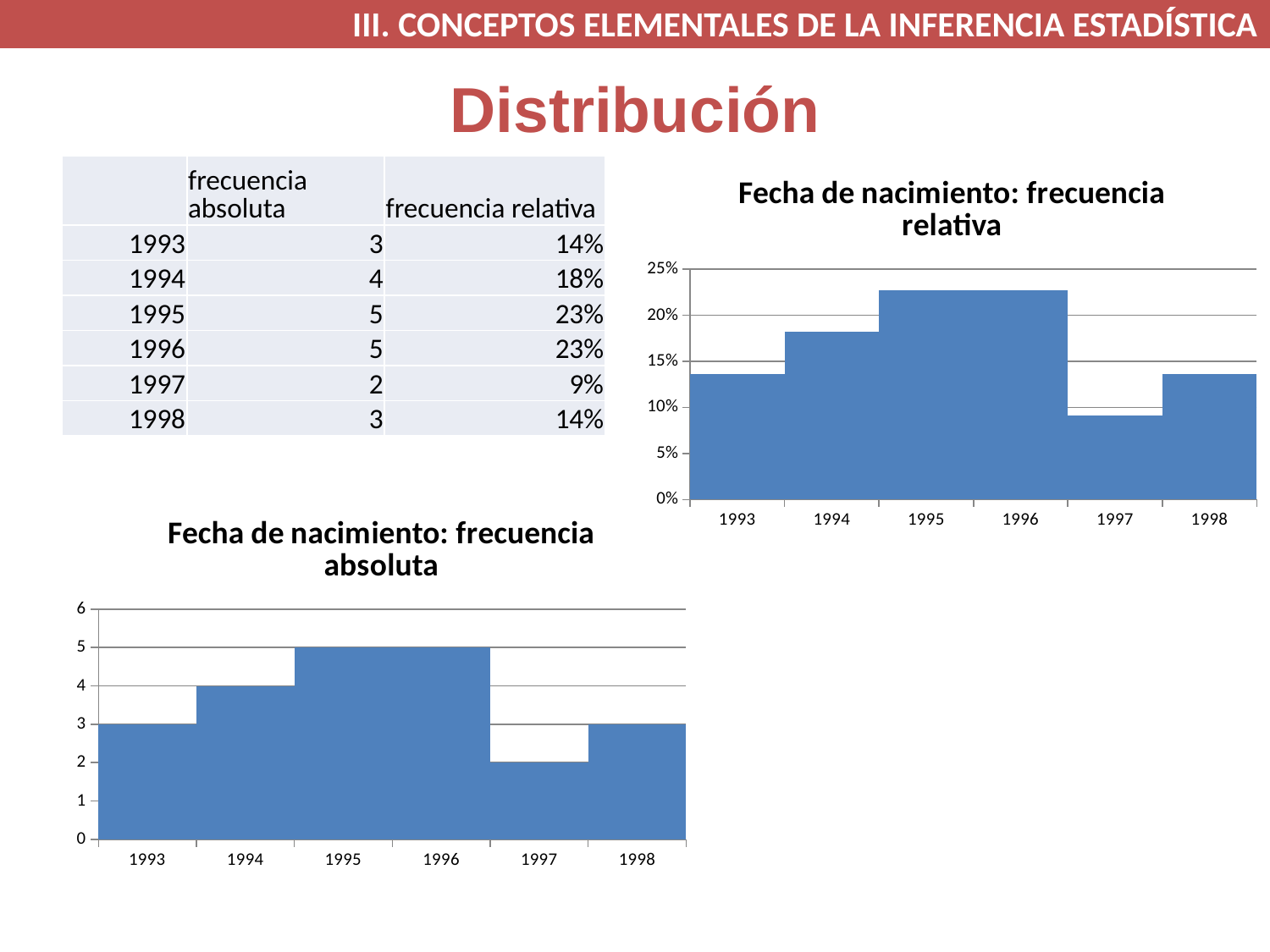
In the chart titled "Fecha de nacimiento: frecuencia relativa", is the value for 1995 greater or less than 20%? greater In the chart titled "Fecha de nacimiento: frecuencia absoluta", what is the value for 1994? 4 In the chart titled "Fecha de nacimiento: frecuencia absoluta", what is the difference between the values for 1995 and 1997? 3 In the chart titled "Fecha de nacimiento: frecuencia absoluta", which year has the lowest value? 1997 In the chart titled "Fecha de nacimiento: frecuencia relativa", which is larger, the value for 1994 or the value for 1998? 1994 In the chart titled "Fecha de nacimiento: frecuencia absoluta", do the values rise or fall from 1993 to 1995? rise In the chart titled "Fecha de nacimiento: frecuencia relativa", which year has the lowest value? 1997 In the chart titled "Fecha de nacimiento: frecuencia absoluta", how many years are shown on the x axis? 6 In the chart titled "Fecha de nacimiento: frecuencia absoluta", which is larger, the value for 1994 or the value for 1998? 1994 In the chart titled "Fecha de nacimiento: frecuencia relativa", is the value for 1997 greater or less than 10%? less What kind of chart is "Fecha de nacimiento: frecuencia relativa"? bar chart In the chart titled "Fecha de nacimiento: frecuencia absoluta", what is the value for 1997? 2